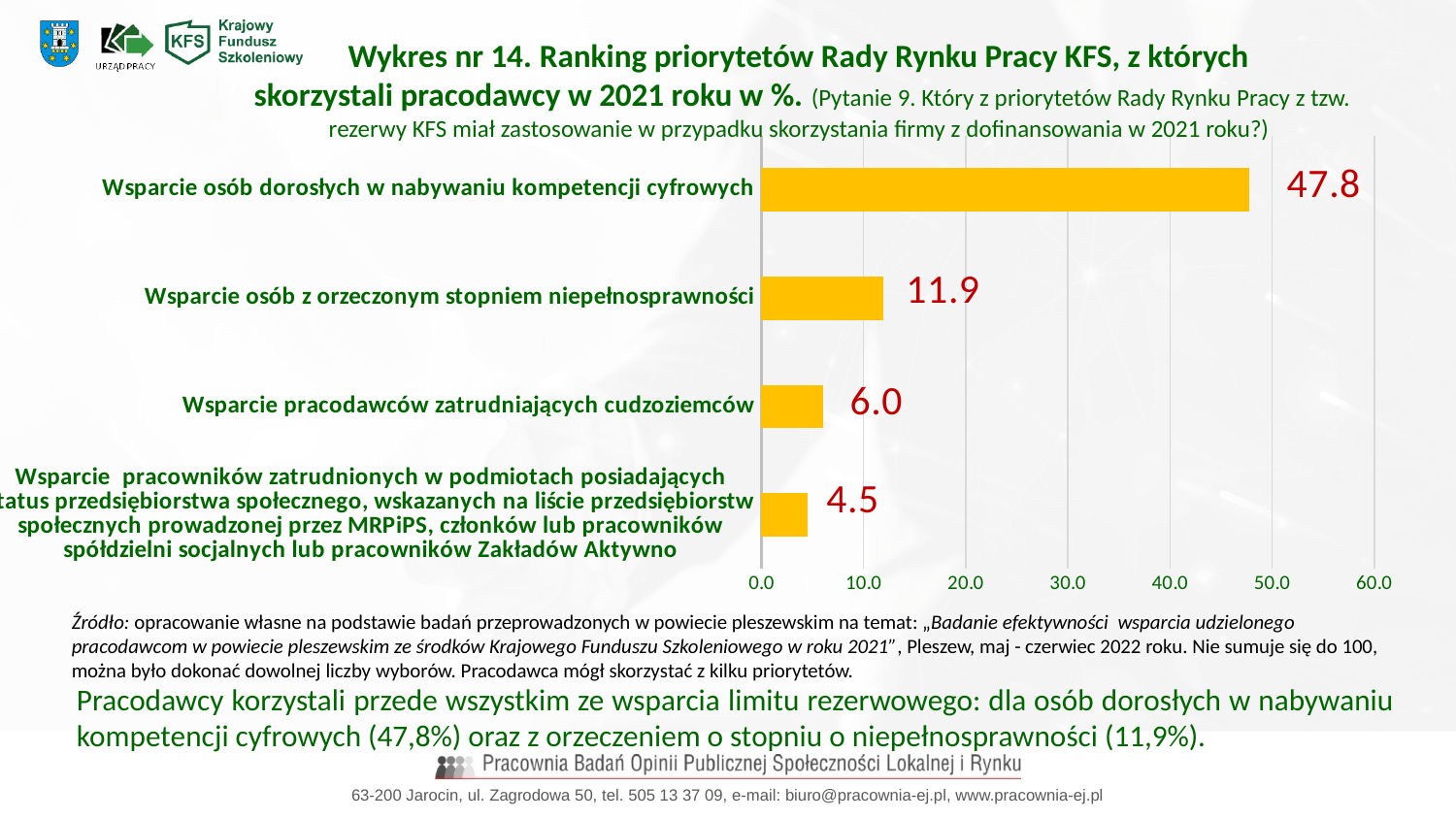
What value is shown for "Wsparcie pracodawców zatrudniających cudzoziemców"? 6.0 What is the difference between the values for "Wsparcie pracodawców zatrudniających cudzoziemców" and the lowest category (4.5)? 1.5 Is the value for "Wsparcie osób dorosłych w nabywaniu kompetencji cyfrowych" greater or less than 40.0? greater How many categories are shown in the chart? 4 What kind of chart is shown on the slide? bar chart What value is shown for "Wsparcie osób z orzeczonym stopniem niepełnosprawności"? 11.9 Which category has the lowest value in the chart? Wsparcie pracowników zatrudnionych w podmiotach posiadających status przedsiębiorstwa społecznego... Which category has the highest value in the chart? Wsparcie osób dorosłych w nabywaniu kompetencji cyfrowych Which is larger: the value for "Wsparcie osób z orzeczonym stopniem niepełnosprawności" or for "Wsparcie pracodawców zatrudniających cudzoziemców"? Wsparcie osób z orzeczonym stopniem niepełnosprawności What value is shown for "Wsparcie osób dorosłych w nabywaniu kompetencji cyfrowych"? 47.8 What is the maximum value shown on the horizontal axis of the chart? 60.0 What is the difference between the values for "Wsparcie osób dorosłych w nabywaniu kompetencji cyfrowych" and "Wsparcie osób z orzeczonym stopniem niepełnosprawności"? 35.9